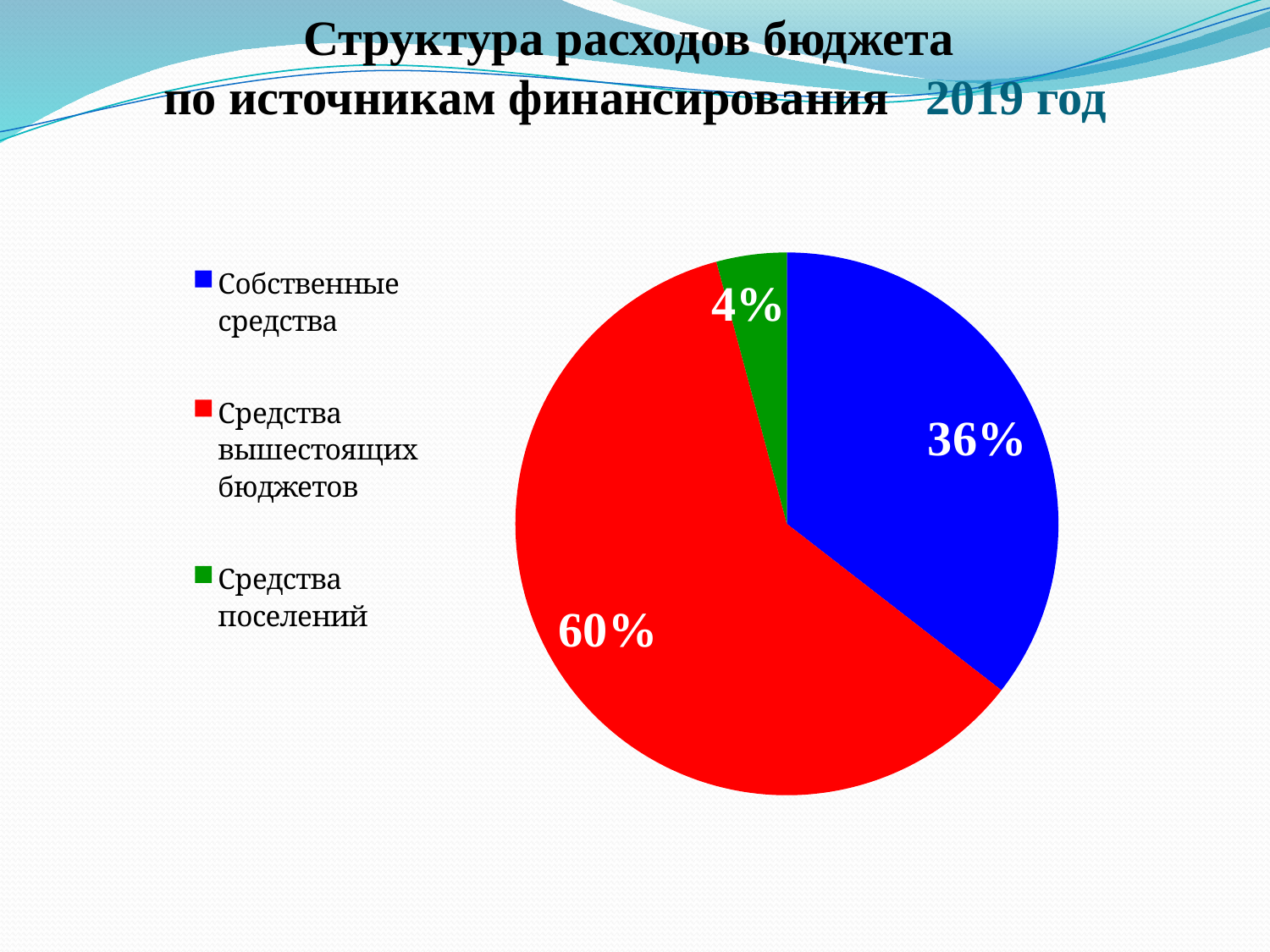
What share of the pie does Средства вышестоящих бюджетов represent? 60% What is the difference in percentage points between Средства вышестоящих бюджетов and Собственные средства? 24 How many entries does the legend list? 3 Which year does the slide title refer to? 2019 год Which category has the largest slice of the pie? Средства вышестоящих бюджетов What share of the pie does Средства поселений represent? 4% Which category has the smallest slice of the pie? Средства поселений What type of chart is shown on the slide? pie chart Which is larger: the share for Собственные средства or the share for Средства поселений? Собственные средства How many categories does the pie chart show? 3 What colour is the slice for Средства вышестоящих бюджетов? red What share of the pie does Собственные средства represent? 36%